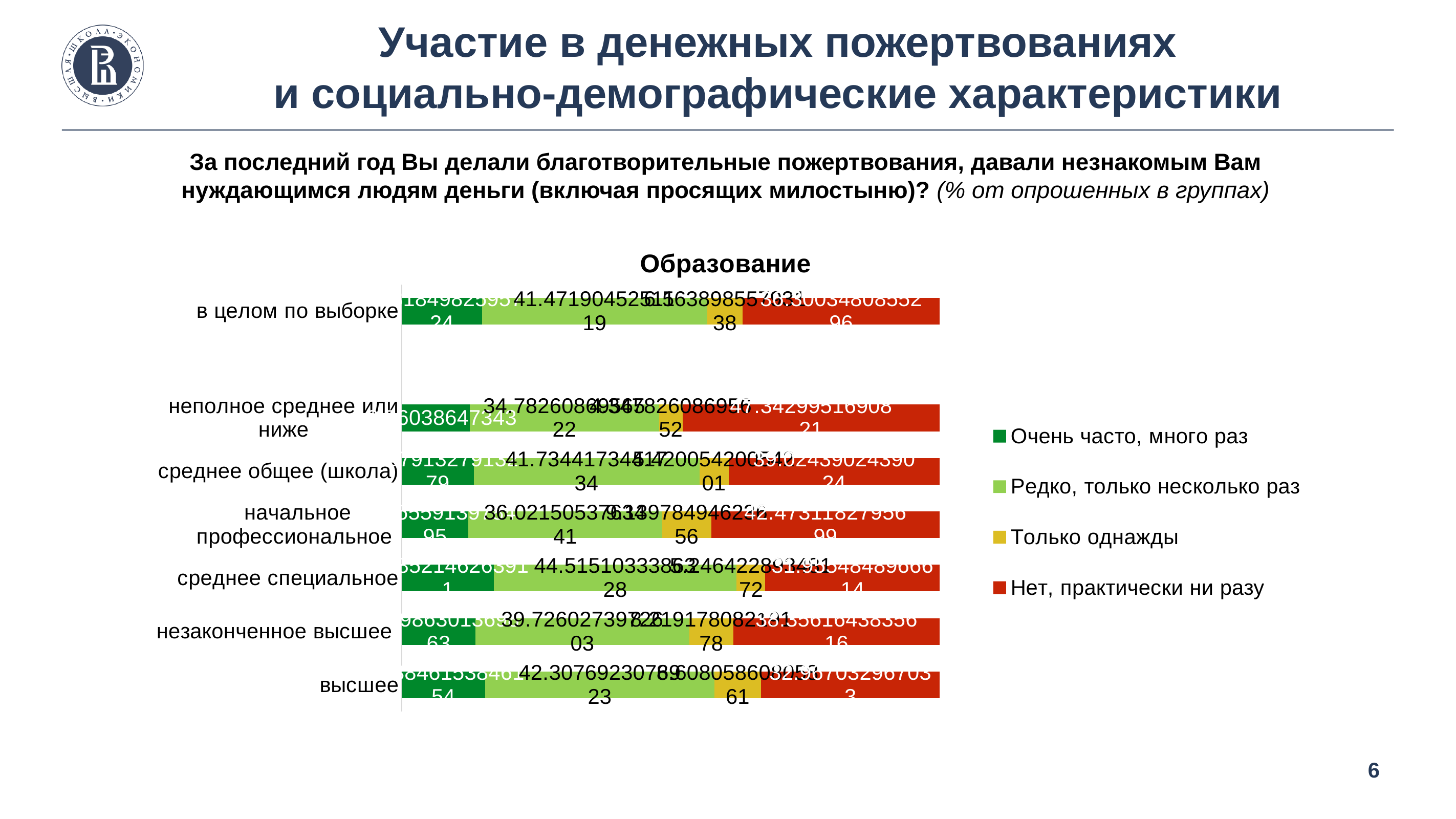
What is the title of the chart? Образование How many series does the legend list? 4 For 'высшее', which segment is larger: 'Очень часто, много раз' or 'Только однажды'? Очень часто, много раз What kind of chart is shown on the slide? Stacked bar chart Which series is shown in red in the legend? Нет, практически ни разу Which category is listed first (at the top) of the chart? в целом по выборке How many categories (education groups) are plotted on the chart? 7 Which category has the smallest segment for 'Редко, только несколько раз'? неполное среднее или ниже For 'среднее специальное', which segment is larger: 'Редко, только несколько раз' or 'Нет, практически ни разу'? Редко, только несколько раз For 'неполное среднее или ниже', which segment is larger: 'Редко, только несколько раз' or 'Нет, практически ни разу'? Нет, практически ни разу Which category has the largest segment for 'Нет, практически ни разу'? неполное среднее или ниже